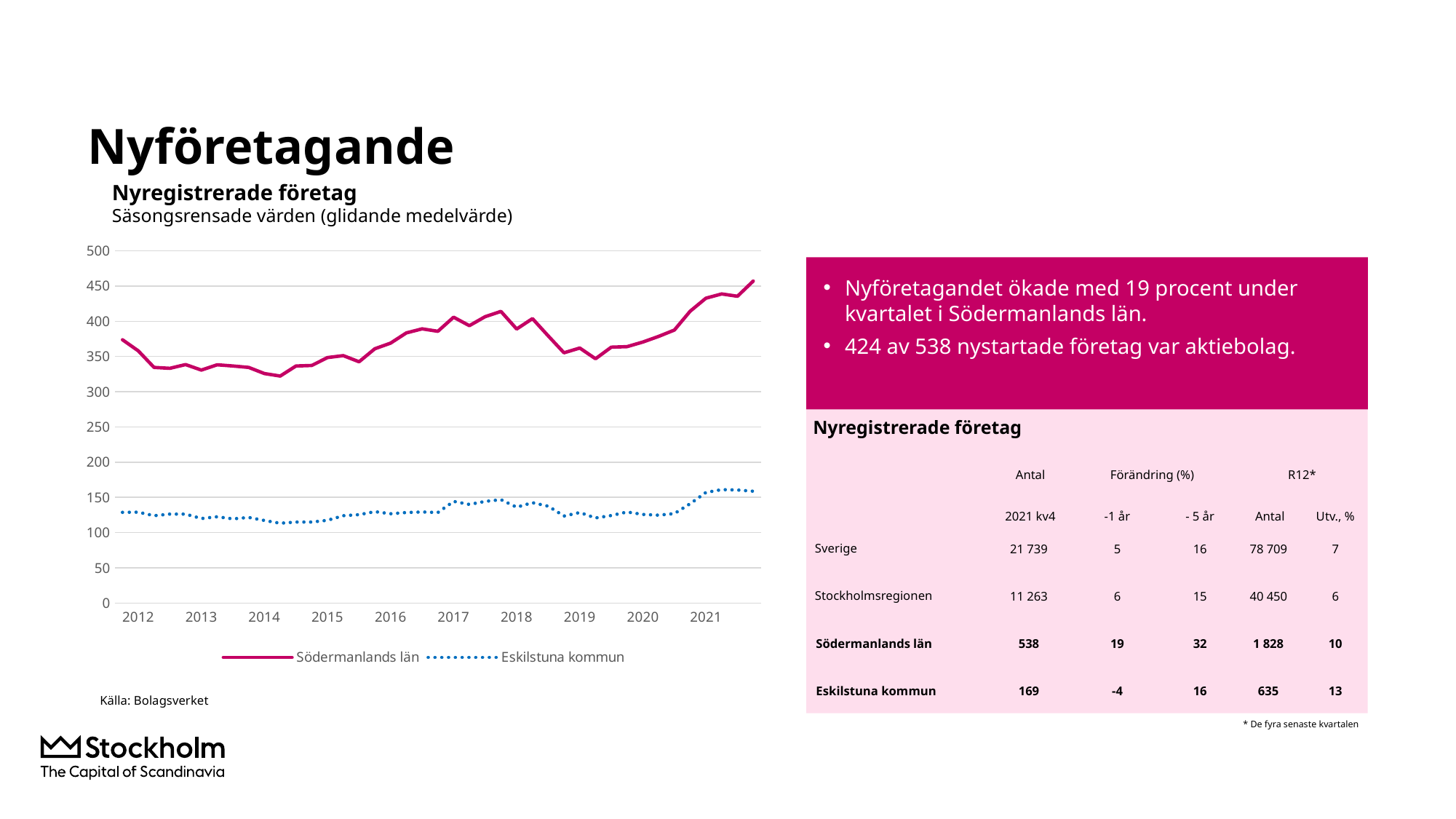
What are the two series named in the chart's legend? Södermanlands län and Eskilstuna kommun Which series has higher values throughout the chart, Södermanlands län or Eskilstuna kommun? Södermanlands län How many year labels are shown on the x axis of the chart? 10 Is the value for Eskilstuna kommun in 2018 greater or less than 100? greater Does the Södermanlands län line rise or fall between 2014 and 2017? rise What kind of chart is shown on the slide? line chart How many series does the chart's legend list? 2 Is the value for Södermanlands län at the start of 2012 greater or less than 350? greater Does the Södermanlands län line rise or fall between 2018 and 2019? fall What is the title of the chart? Nyregistrerade företag Is the value for Södermanlands län at the end of 2021 greater or less than 400? greater